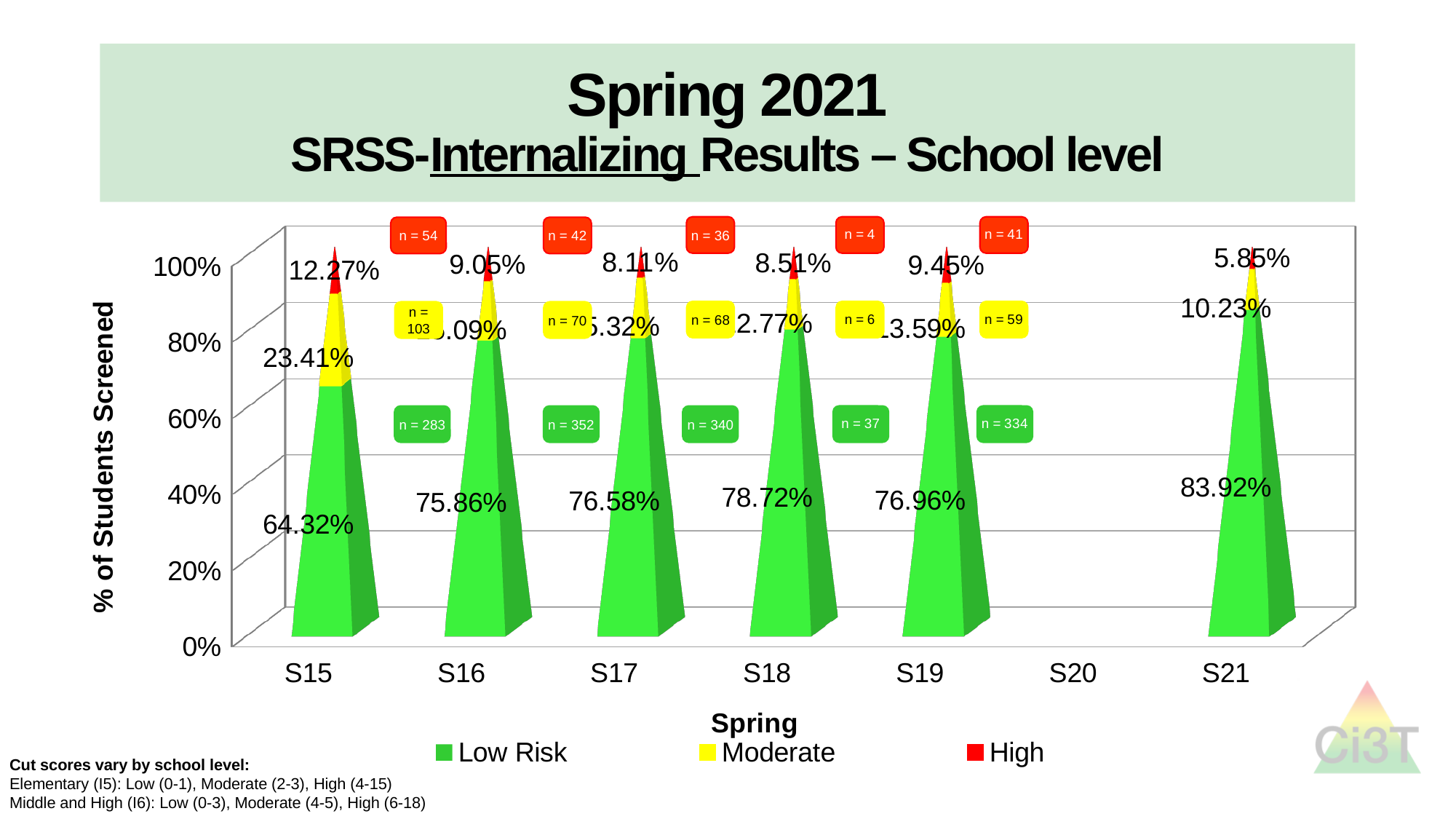
What is the title of the vertical axis? % of Students Screened What kind of chart is shown on the slide? Stacked bar chart What is the Low Risk percentage for S15? 64.32% What is the Moderate percentage for S19? 13.59% Which school has the lowest Low Risk percentage? S15 Which school has the highest High percentage? S15 How many series does the legend list? 3 What is the difference between the Low Risk percentages for S21 and S15? 19.60 percentage points What is the Moderate percentage for S18? 12.77% What is the High percentage for S21? 5.85% Which school has the highest Low Risk percentage? S21 Which has a larger High percentage, S16 or S19? S19